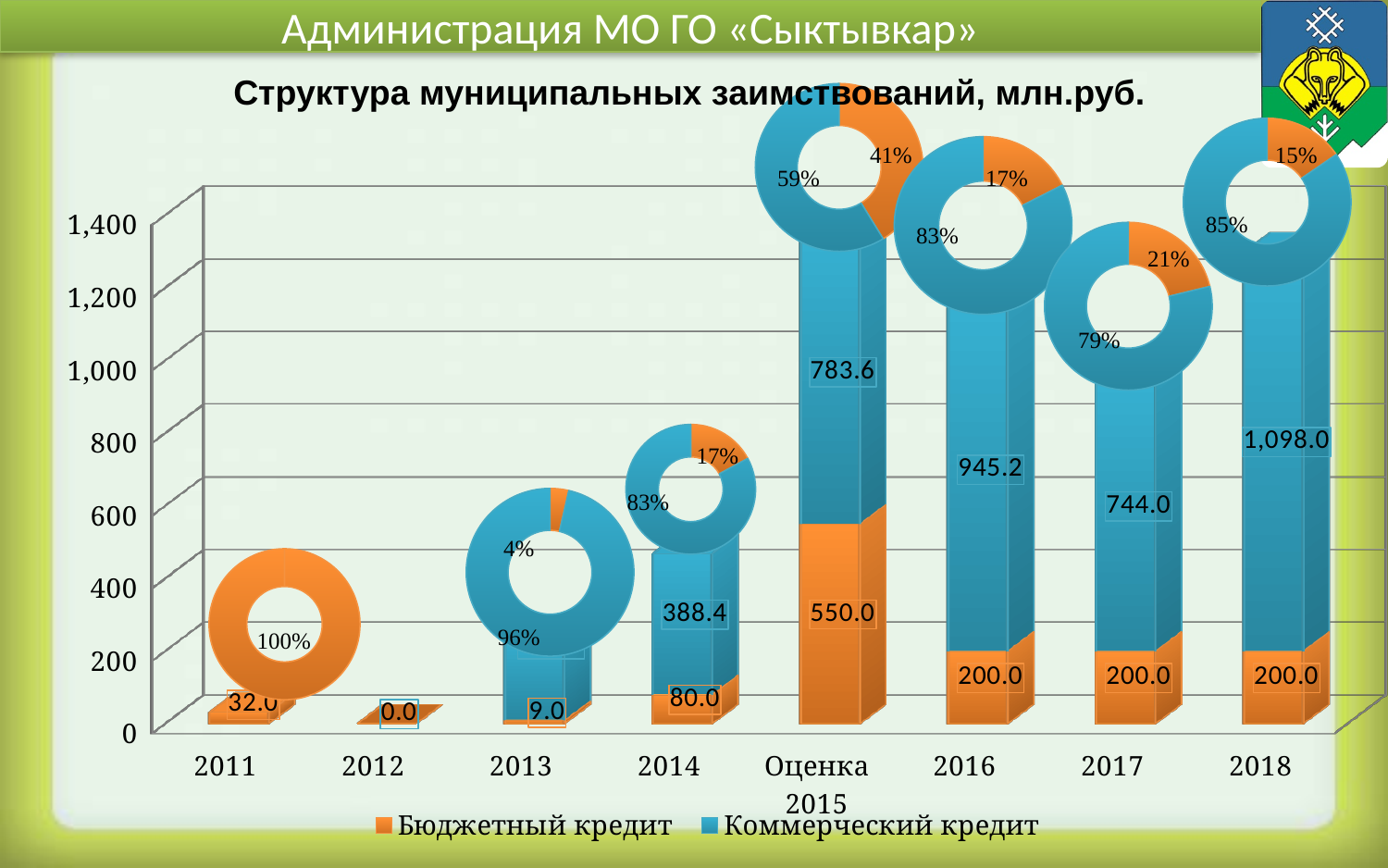
What is the value of Коммерческий кредит for 2014? 388.4 What is the value of Бюджетный кредит for Оценка 2015? 550.0 What is the value of Коммерческий кредит for 2018? 1,098.0 In which year is Коммерческий кредит highest? 2018 What is the total of the stacked bar for 2016? 1,145.2 Is the value of Коммерческий кредит for 2013 greater or less than 400? less In which year is Бюджетный кредит lowest? 2012 How many categories are shown on the x axis? 8 How many series does the legend list? 2 Which is larger: Коммерческий кредит in 2016 or in 2017? 2016 In the donut above the 2017 bar, what share is shown for the blue segment? 79% What is the difference between Коммерческий кредит in 2018 and in 2016? 152.8